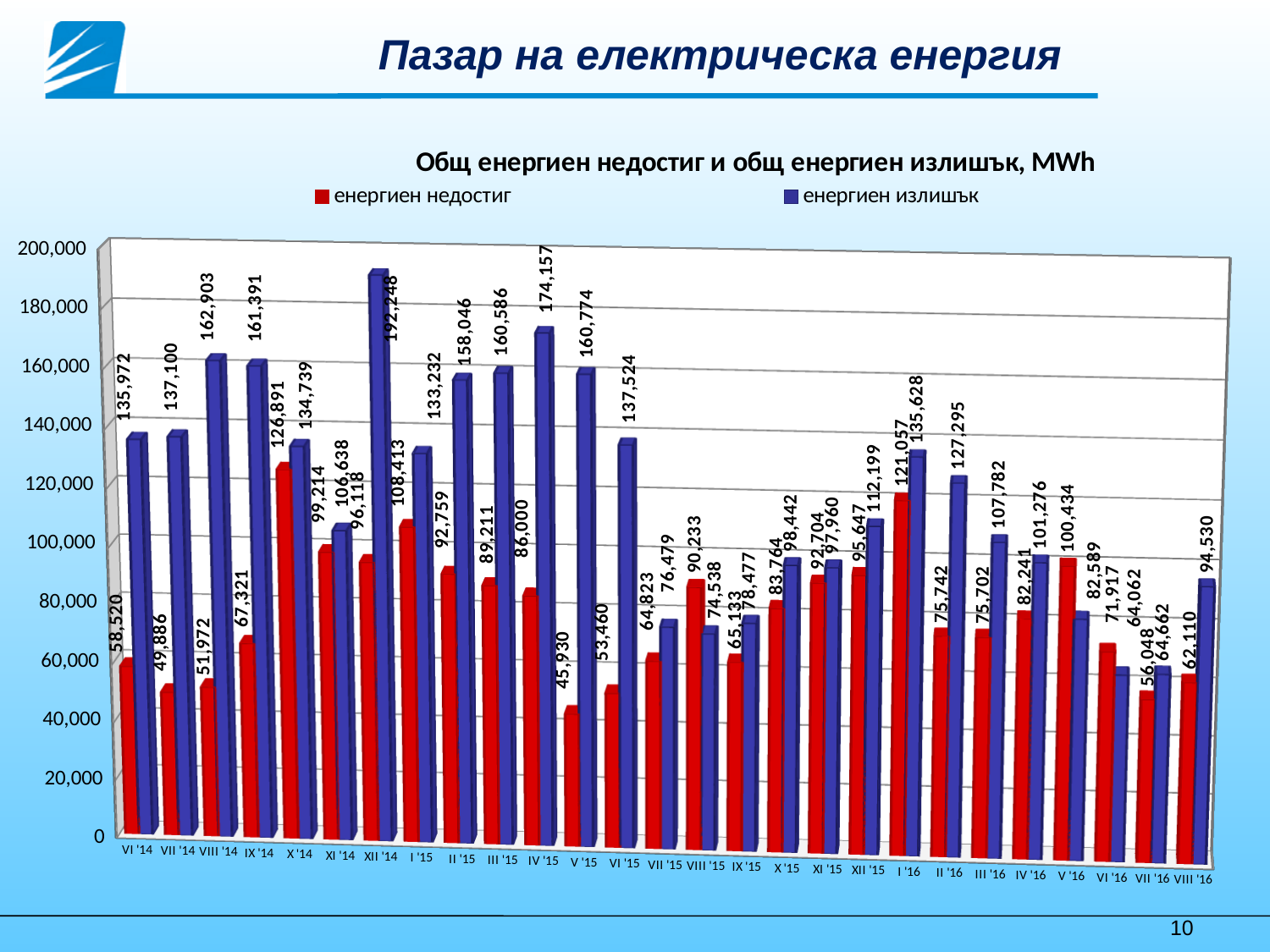
In V '16, which is larger: енергиен недостиг or енергиен излишък? енергиен недостиг How many series does the legend list? 2 In which month is енергиен недостиг the highest? X '14 What is the difference between енергиен излишък and енергиен недостиг in XII '14? 96,130 What is the value of енергиен излишък for XII '14? 192,248 In which month is енергиен излишък the highest? XII '14 What type of chart is shown on the slide? bar chart What is the value of енергиен недостиг for V '15? 45,930 How many months (categories) are shown on the x axis? 27 In which month is енергиен недостиг the lowest? V '15 What is the value of енергиен недостиг for I '16? 121,057 What unit is given in the chart title? MWh